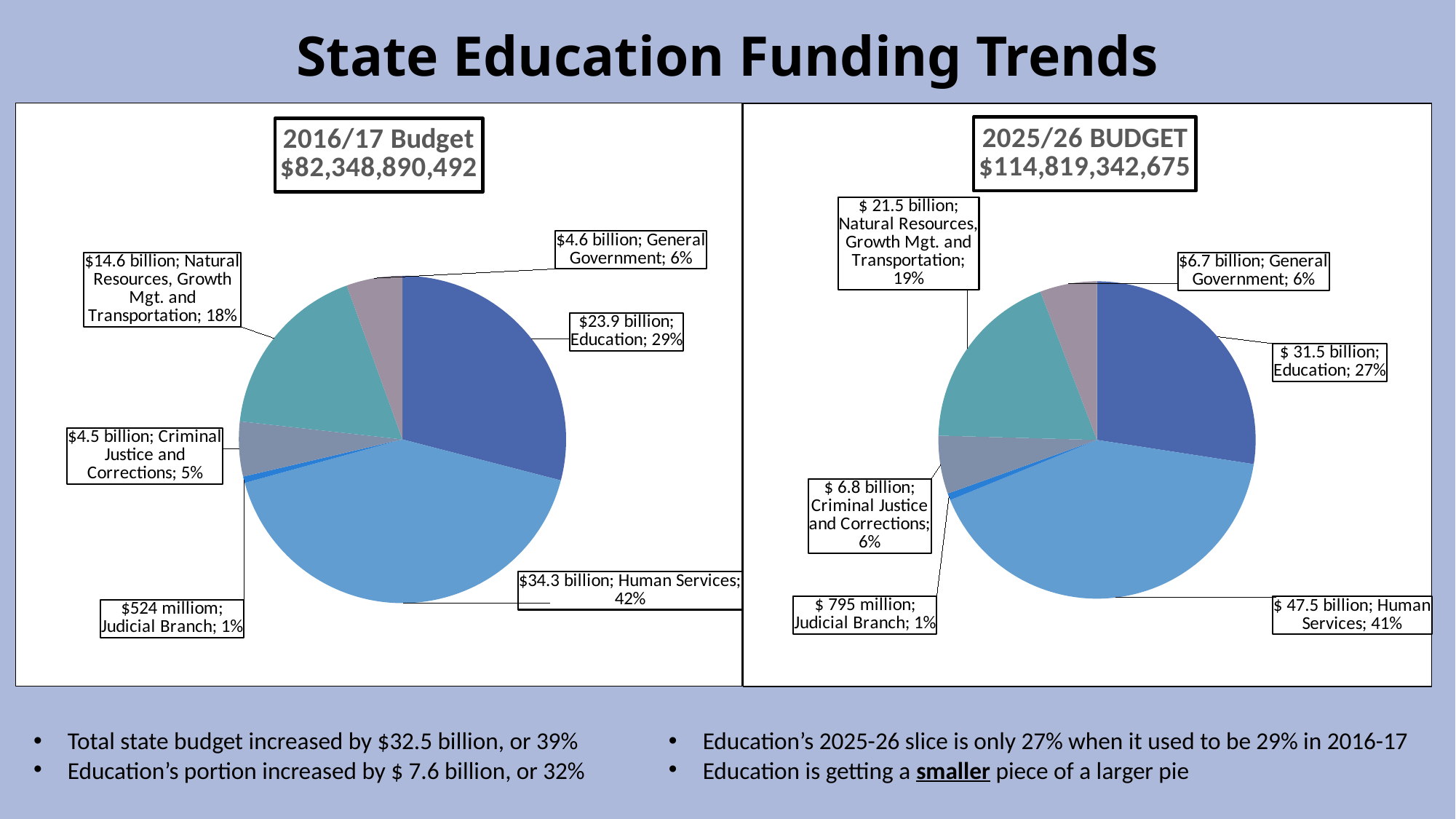
In the 2016/17 Budget pie chart, what share of the pie does Education have? 29% In the 2025/26 BUDGET pie chart, what is the difference in percentage points between Human Services and Education? 14% In the 2016/17 Budget pie chart, which is larger: General Government or Criminal Justice and Corrections? General Government What type of chart is used on the left side of the slide for the 2016/17 Budget? Pie chart How many slices does the 2016/17 Budget pie chart have? 6 In the 2025/26 BUDGET pie chart, what is the value for Judicial Branch? $ 795 million In the 2025/26 BUDGET pie chart, what share of the pie does Human Services have? 41% In the 2016/17 Budget pie chart, which category has the largest slice? Human Services In the 2016/17 Budget pie chart, what is the value for Education? $23.9 billion In the 2025/26 BUDGET pie chart, which category has the smallest slice? Judicial Branch In the 2025/26 BUDGET pie chart, what is the value for Natural Resources, Growth Mgt. and Transportation? $ 21.5 billion What total budget amount is shown in the title box of the 2025/26 BUDGET chart? $114,819,342,675